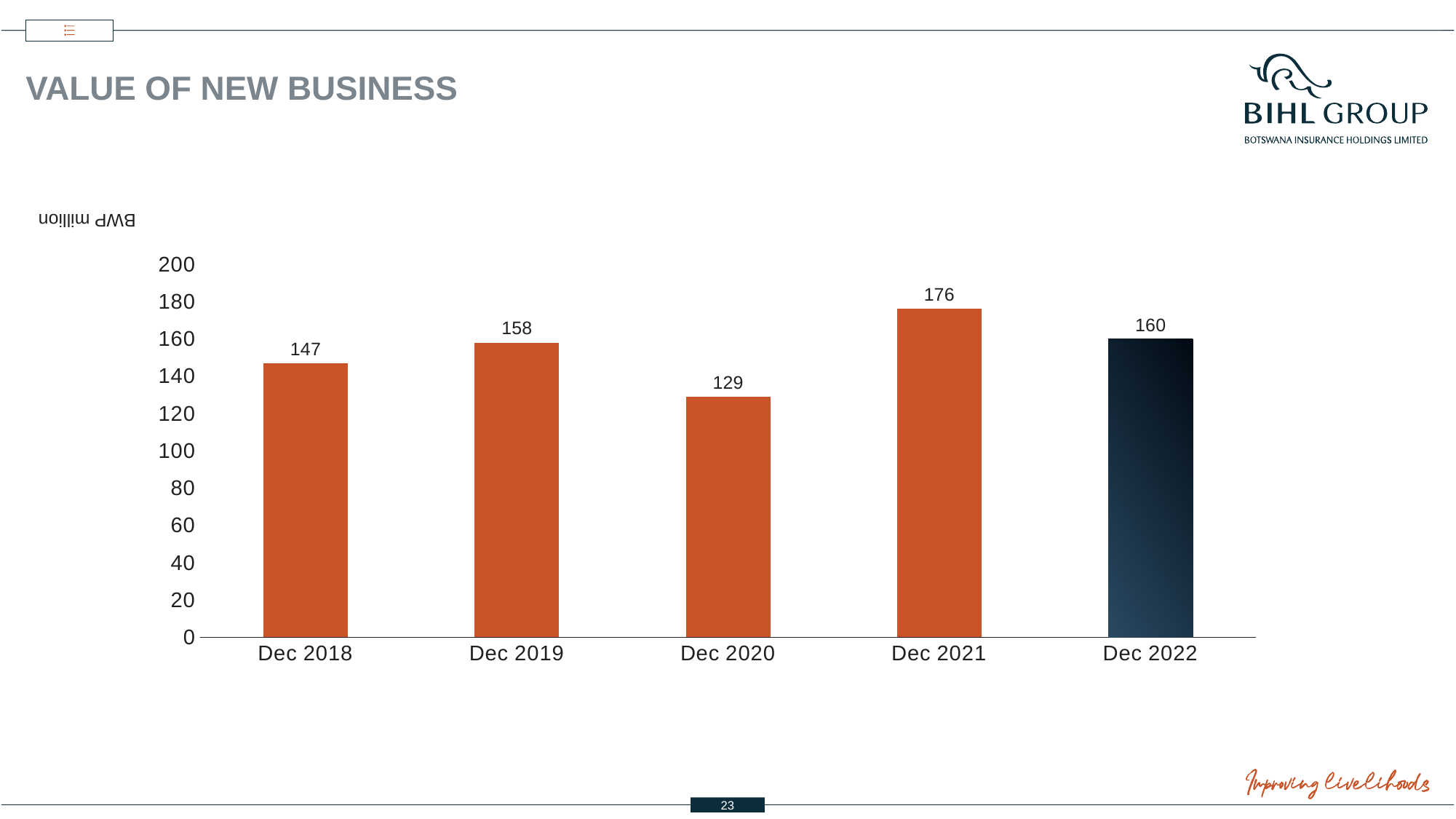
What is the difference between the Dec 2021 and Dec 2022 values? 16 Is the value for Dec 2021 greater or less than 160? greater How many periods are shown on the chart? 5 What is the value of new business for Dec 2022? 160 What kind of chart is shown on the slide? Bar chart Which period has the lowest value of new business? Dec 2020 Which is larger, the value for Dec 2018 or Dec 2019? Dec 2019 What is the difference between the Dec 2019 and Dec 2020 values? 29 What is the value of new business for Dec 2018? 147 Which period has the highest value of new business? Dec 2021 What is the value of new business for Dec 2020? 129 What unit is shown on the chart's axis label? BWP million